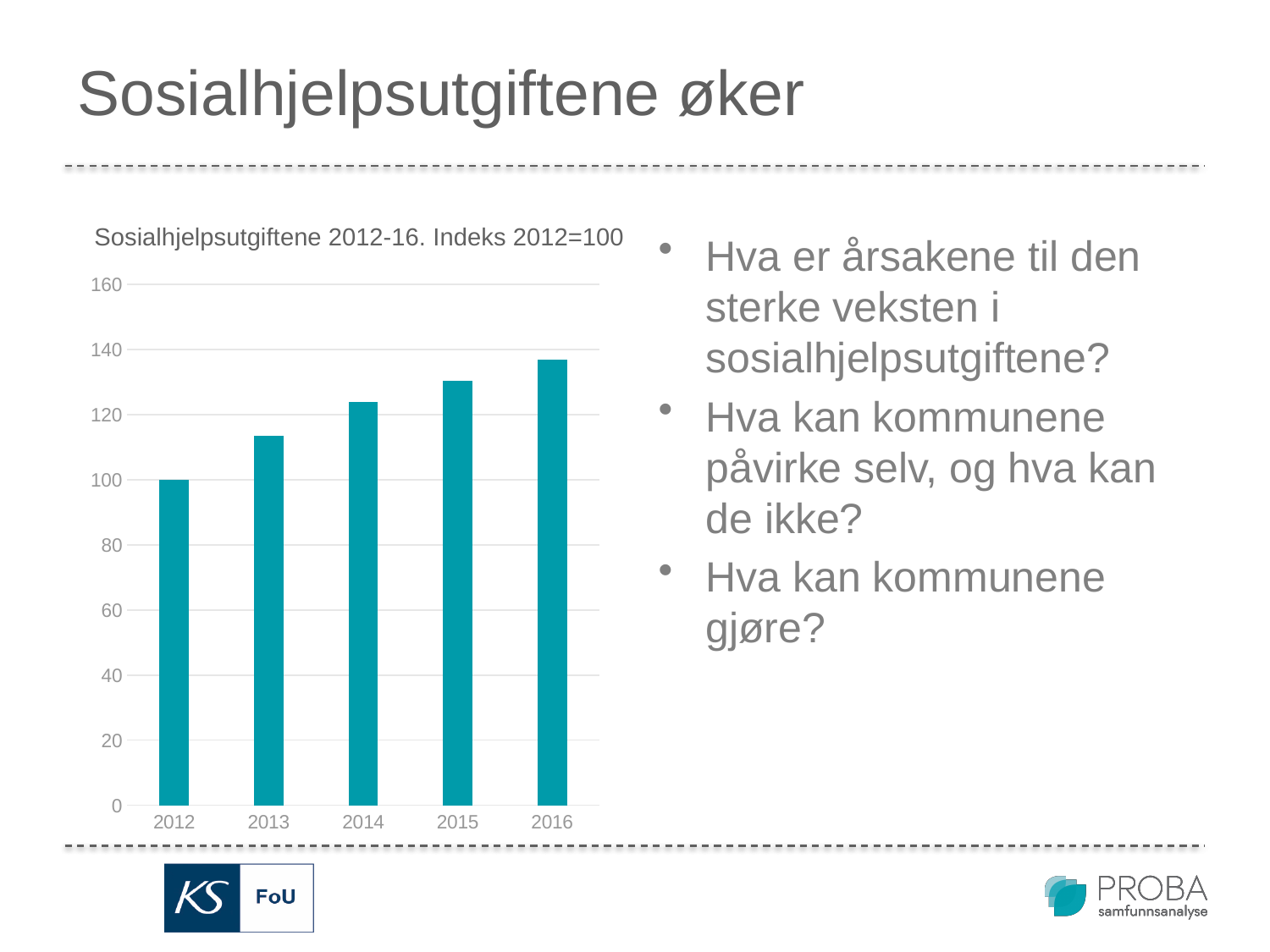
Is the value for 2013 greater or less than 120? less What is the title of the chart? Sosialhjelpsutgiftene 2012-16. Indeks 2012=100 Is the value for 2014 greater or less than 120? greater Which year has the lowest value in the chart? 2012 Which is larger, the value for 2014 or the value for 2016? 2016 What kind of chart is shown on the slide? bar chart Which year has the highest value in the chart? 2016 Is the value for 2015 greater or less than 140? less What is the index value for 2012? 100 How many years are shown on the x axis of the chart? 5 Do the values rise or fall from 2012 to 2016? rise